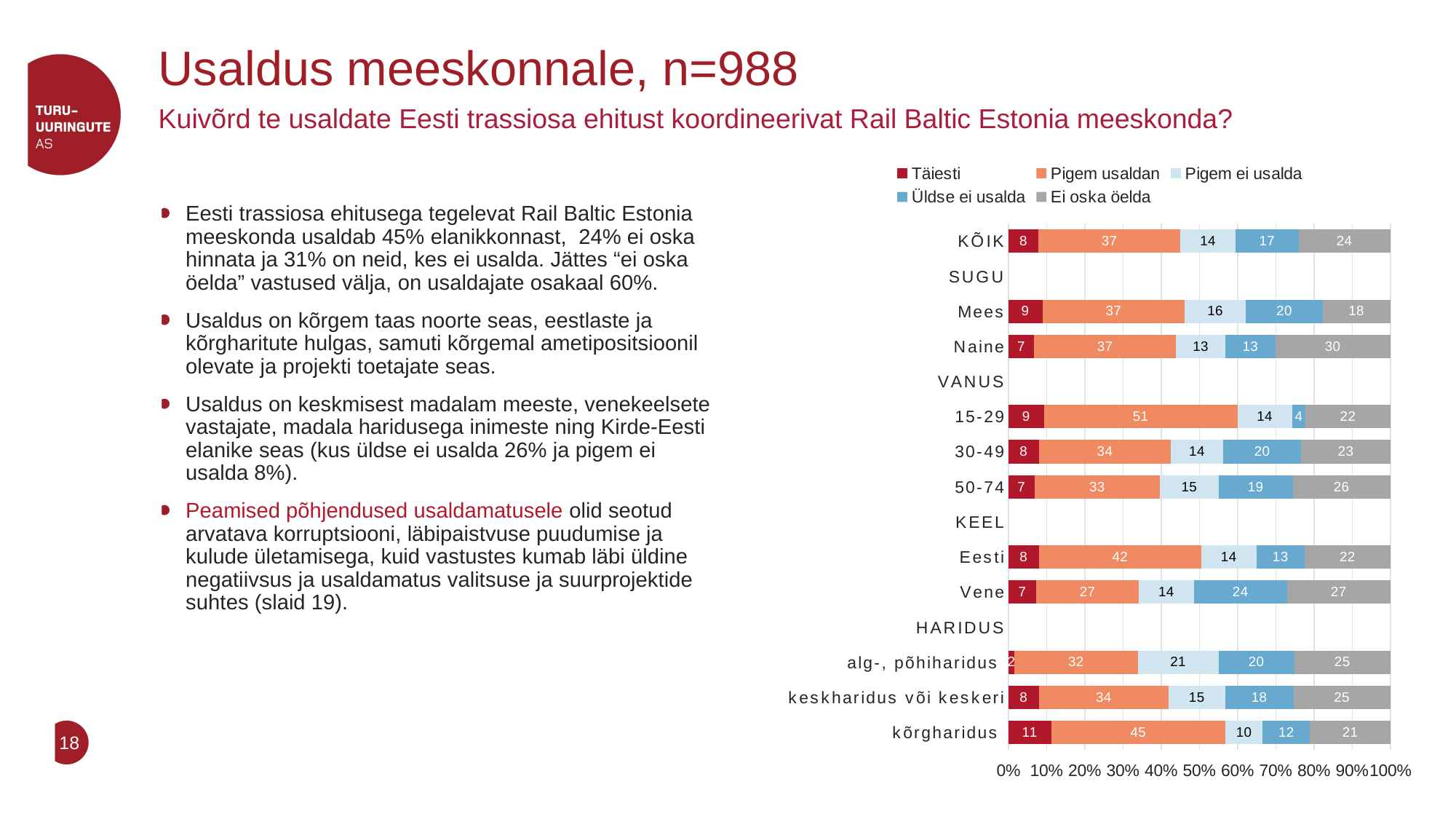
How many categories have bars plotted in the chart? 11 Which category has the highest "Pigem usaldan" value? 15-29 What colour represents the "Ei oska öelda" series? grey How many series does the legend list? 5 What is the "Üldse ei usalda" value for Vene? 24 What is the difference between the "Pigem usaldan" values for Eesti and Vene? 15 Which category has the lowest "Täiesti" value? alg-, põhiharidus What type of chart is shown on the slide? stacked bar chart What is the "Ei oska öelda" value for Naine? 30 What is the "Pigem usaldan" value for the 15-29 age group? 51 Which has a larger "Üldse ei usalda" value, Mees or Naine? Mees What is the total of the stacked bar for KÕIK? 100